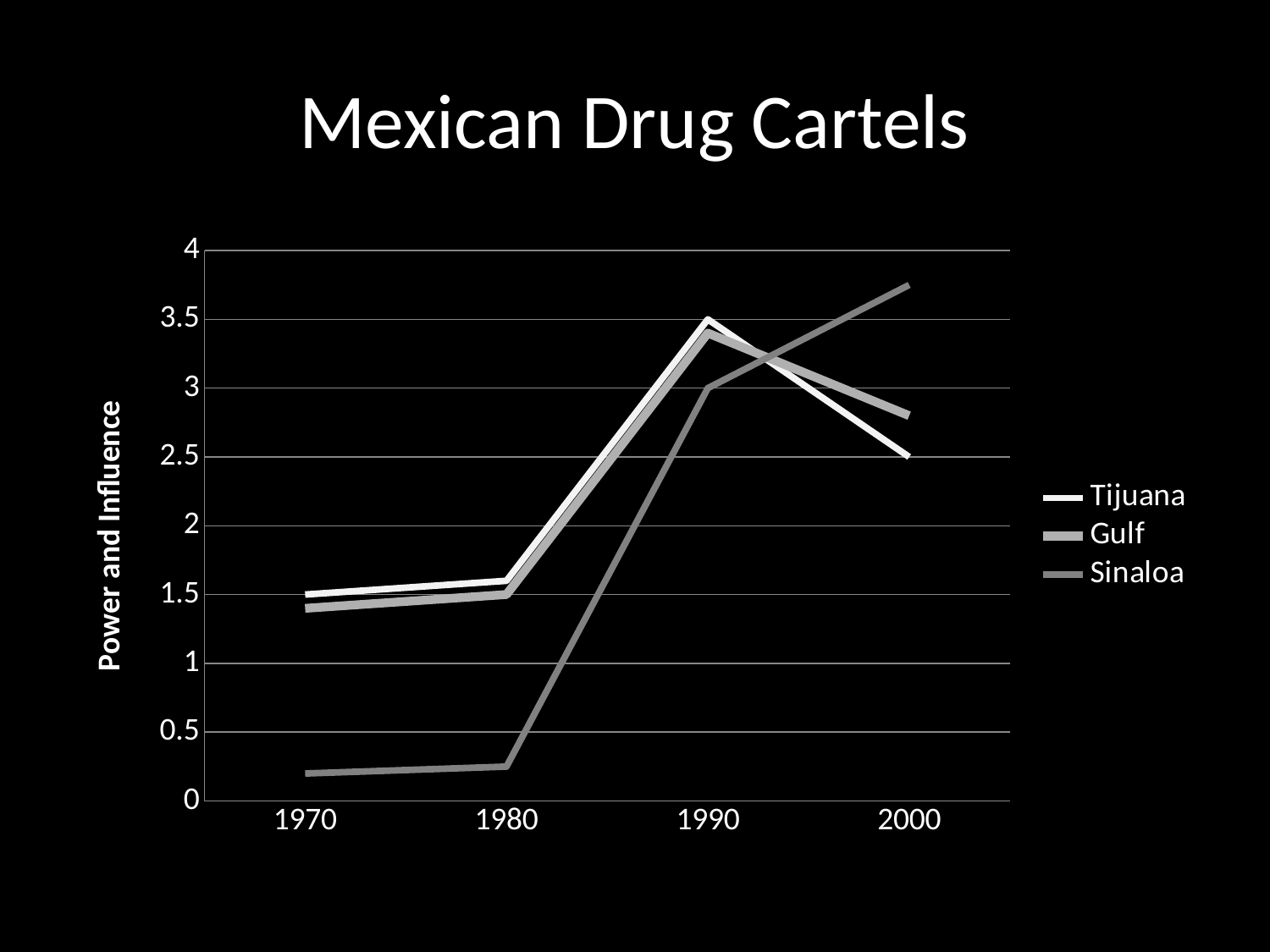
What is the value for Tijuana in 2000? 2.5 Is the value for Sinaloa in 2000 greater or less than 3.5? greater How many years are shown on the x axis? 4 What is the value for Sinaloa in 1990? 3 How many series does the legend list? 3 Which cartel has the highest value in 2000? Sinaloa In 1980, which is larger: the value for Tijuana or the value for Sinaloa? Tijuana Which cartel has the lowest value in 1970? Sinaloa What is the title of the y axis? Power and Influence Does the Sinaloa line rise or fall from 1970 to 2000? rise Is the value for Sinaloa in 1970 greater or less than 0.5? less What kind of chart is shown on the slide? line chart